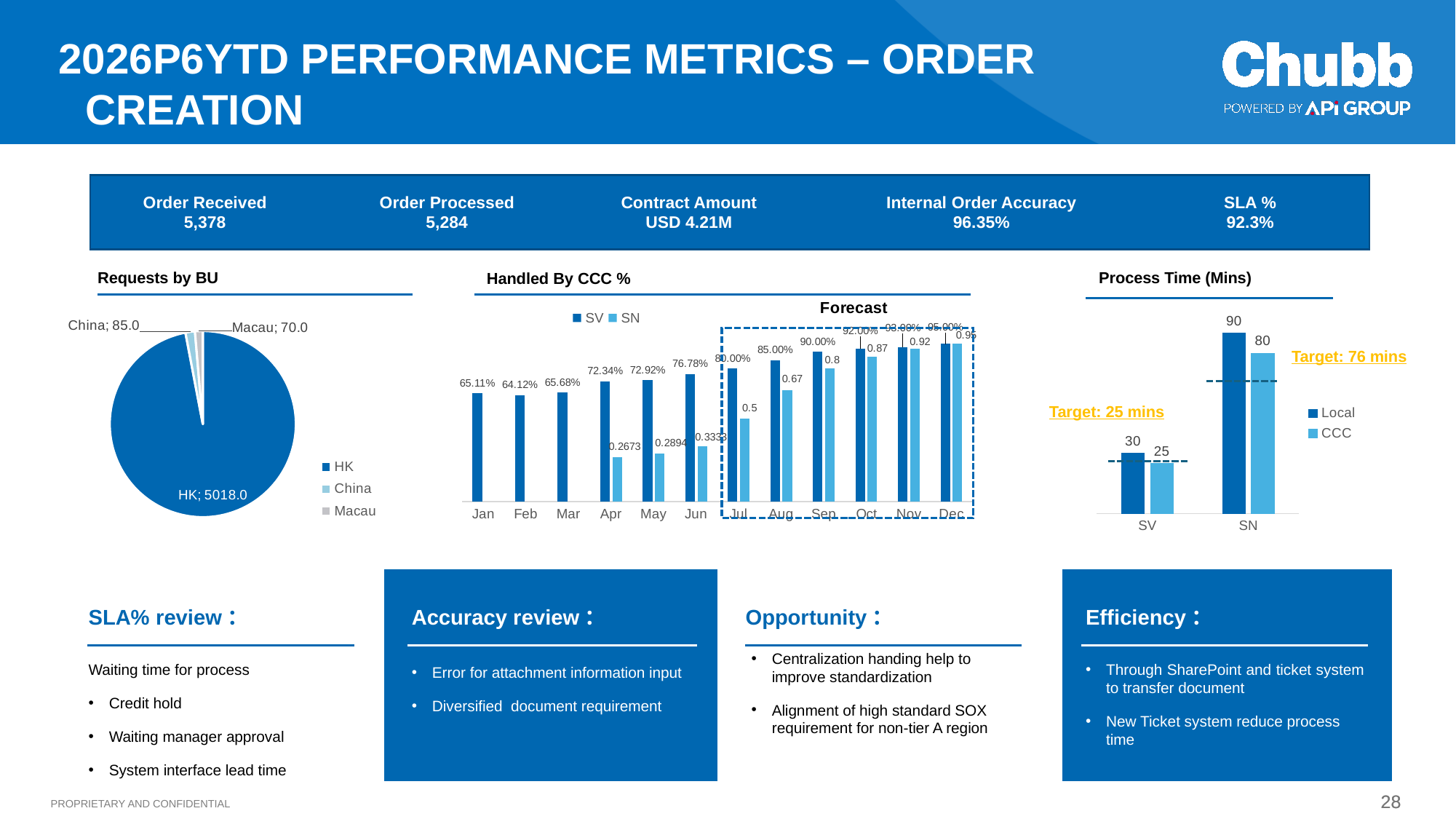
In the Handled By CCC % chart, what is the SV value for Jan? 65.11% What kind of chart is Requests by BU? Pie chart In the Process Time (Mins) chart, what is the Local value for SN? 90 How many series does the legend of the Handled By CCC % chart list? 2 In the Requests by BU pie chart, which BU has the smallest slice? Macau In the Handled By CCC % chart, do the SN values rise or fall from Apr to Dec? Rise In the Handled By CCC % chart, what is the SN value for Jul? 0.5 In the Handled By CCC % chart, which month has the lowest SV value? Feb In the Requests by BU pie chart, what is the value for HK? 5018.0 How many slices does the Requests by BU pie chart have? 3 In the Requests by BU pie chart, what is the difference between the China and Macau values? 15.0 In the Process Time (Mins) chart, what is the difference between the Local and CCC values for SN? 10